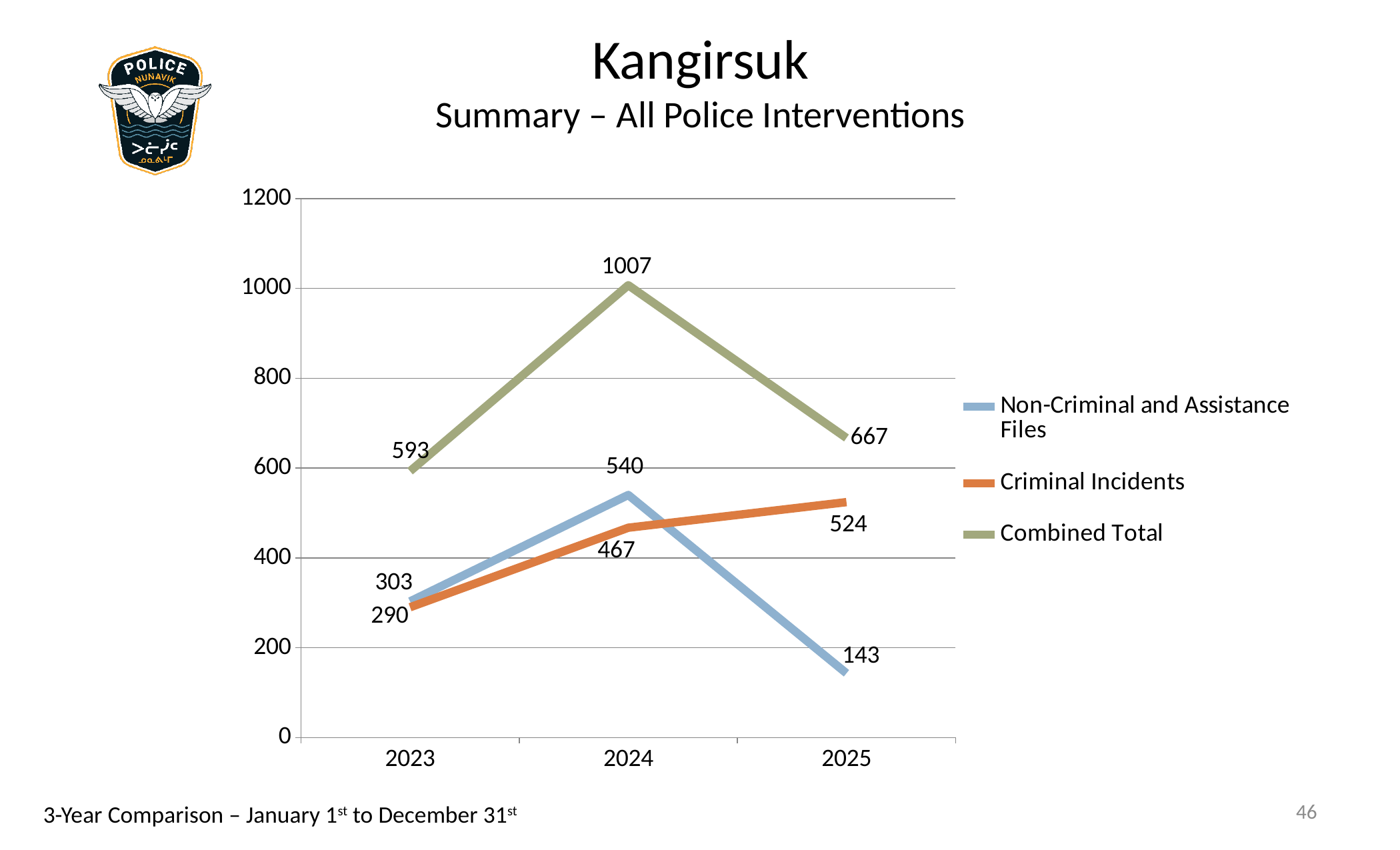
How many series does the legend list? 3 What is the value for Non-Criminal and Assistance Files in 2025? 143 What kind of chart is shown? line chart What is the Criminal Incidents value for 2023? 290 In which year is the Combined Total highest? 2024 Is the Combined Total for 2023 greater or less than 400? greater How many years are shown on the x axis? 3 What is the Combined Total value for 2024? 1007 In which year is the Non-Criminal and Assistance Files value lowest? 2025 Which is larger in 2025: Criminal Incidents or Non-Criminal and Assistance Files? Criminal Incidents What is the difference between the Combined Total in 2024 and in 2025? 340 Do the Criminal Incidents values rise or fall from 2023 to 2025? rise